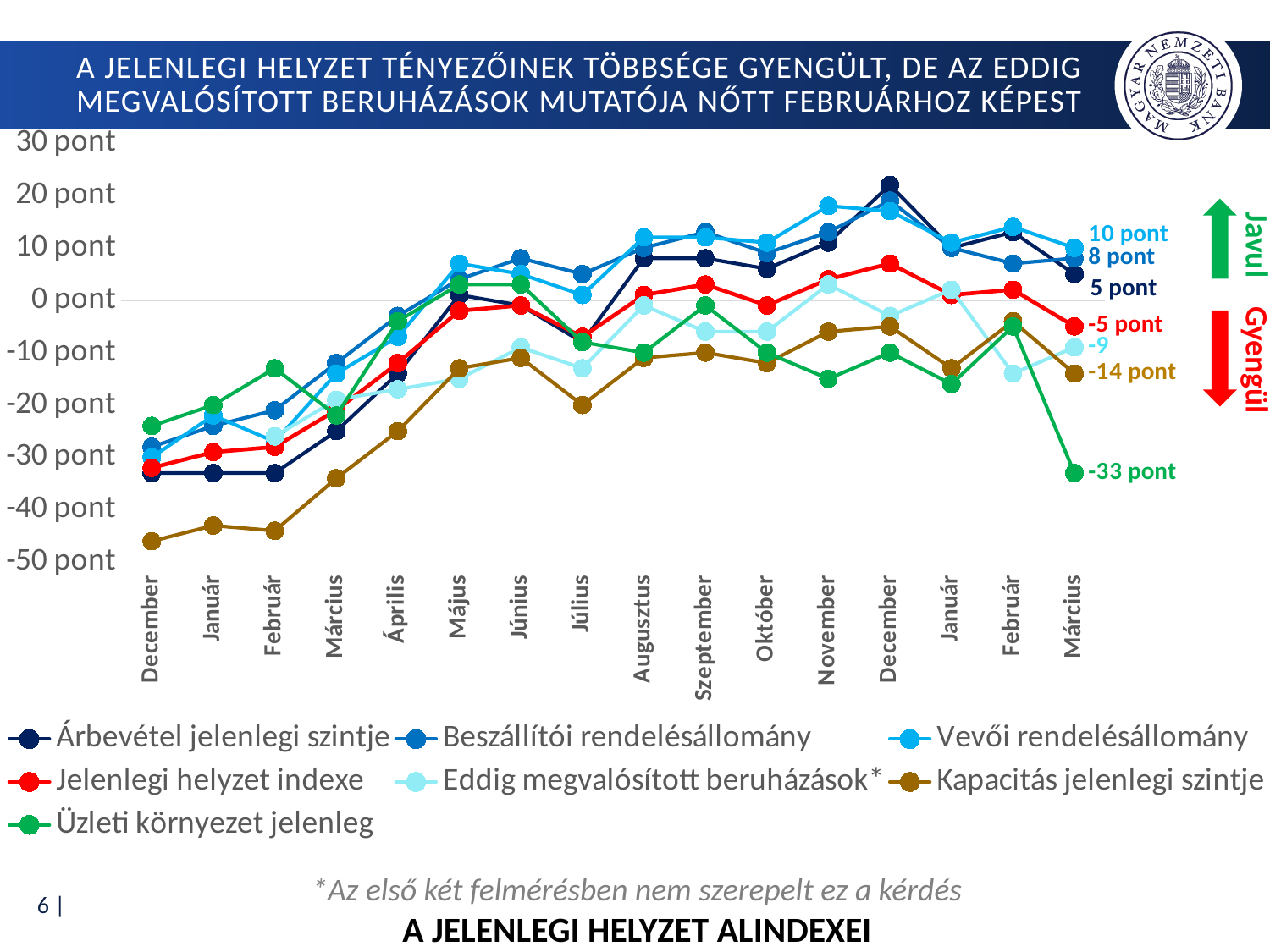
How many series does the legend list? 7 What is the difference between Árbevétel jelenlegi szintje and Jelenlegi helyzet indexe in the final March? 10 pont How many months are shown along the x axis? 16 Which series has the lowest value in the final March? Üzleti környezet jelenleg In the final March, which is larger: Beszállítói rendelésállomány or Árbevétel jelenlegi szintje? Beszállítói rendelésállomány What is the value of Vevői rendelésállomány in the final March? 10 pont Is the value for Kapacitás jelenlegi szintje in the first December greater or less than -40 pont? less What is the title printed at the bottom of the chart? A jelenlegi helyzet alindexei What is the value of Üzleti környezet jelenleg in the final March? -33 pont What kind of chart is shown on the slide? line chart Which series has the highest value in the final March? Vevői rendelésállomány What is the value of Kapacitás jelenlegi szintje in the final March? -14 pont